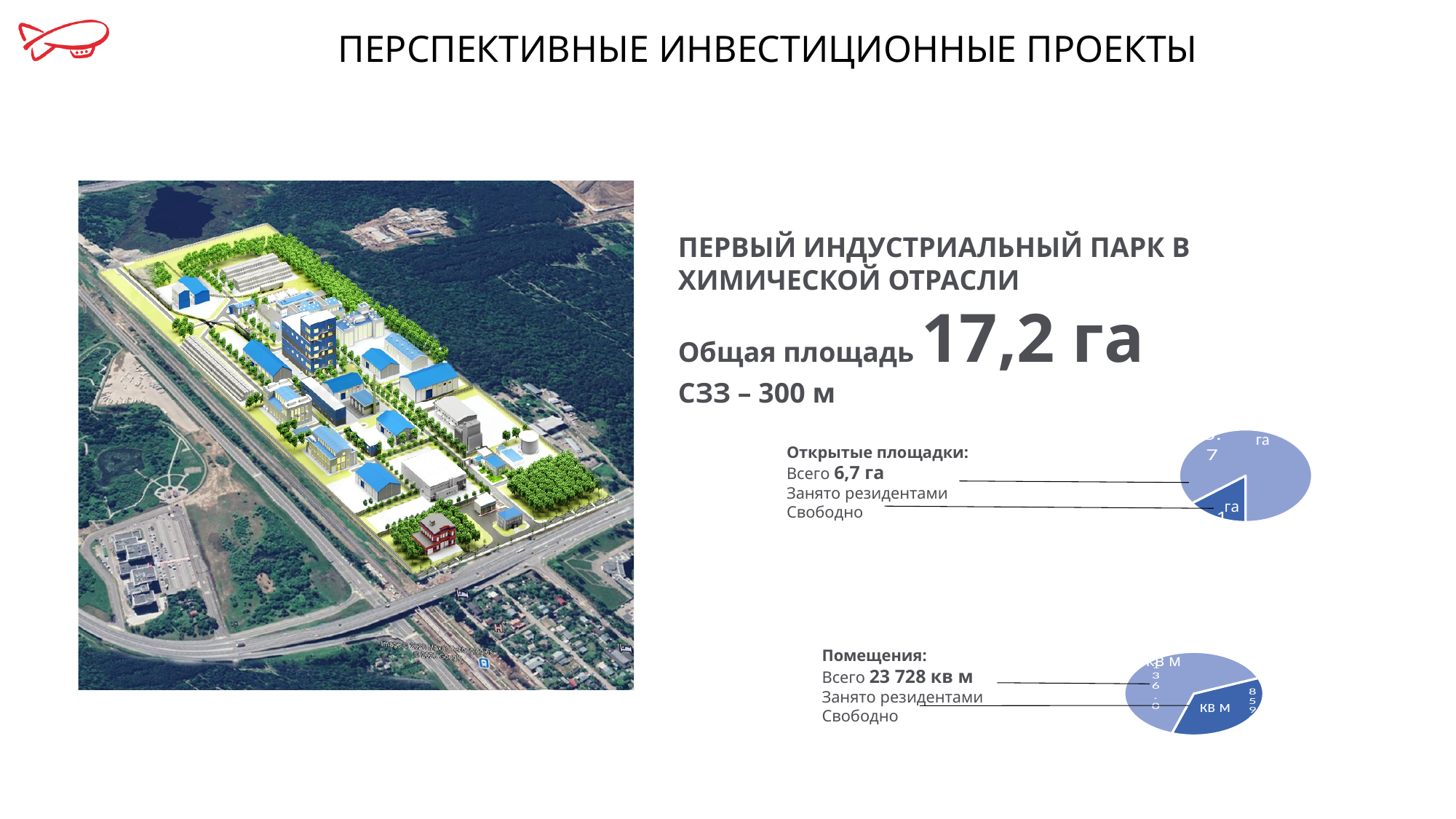
In the bottom pie chart (Помещения), which slice is larger, the light blue one or the dark blue one? light blue What unit appears in the data labels of the bottom pie chart (Помещения)? кв м In the top pie chart (Открытые площадки), which slice is larger, the light blue one or the dark blue one? light blue What kind of chart is shown next to the 'Открытые площадки' text? pie chart What kind of chart is shown next to the 'Помещения' text? pie chart In the bottom pie chart (Помещения), does the dark blue slice take up more or less than half of the pie? less What unit appears in the data labels of the top pie chart (Открытые площадки)? га In the top pie chart (Открытые площадки), does the dark blue slice take up more or less than half of the pie? less In the bottom pie chart (Помещения), how many slices are there? 2 In the top pie chart (Открытые площадки), how many slices are there? 2